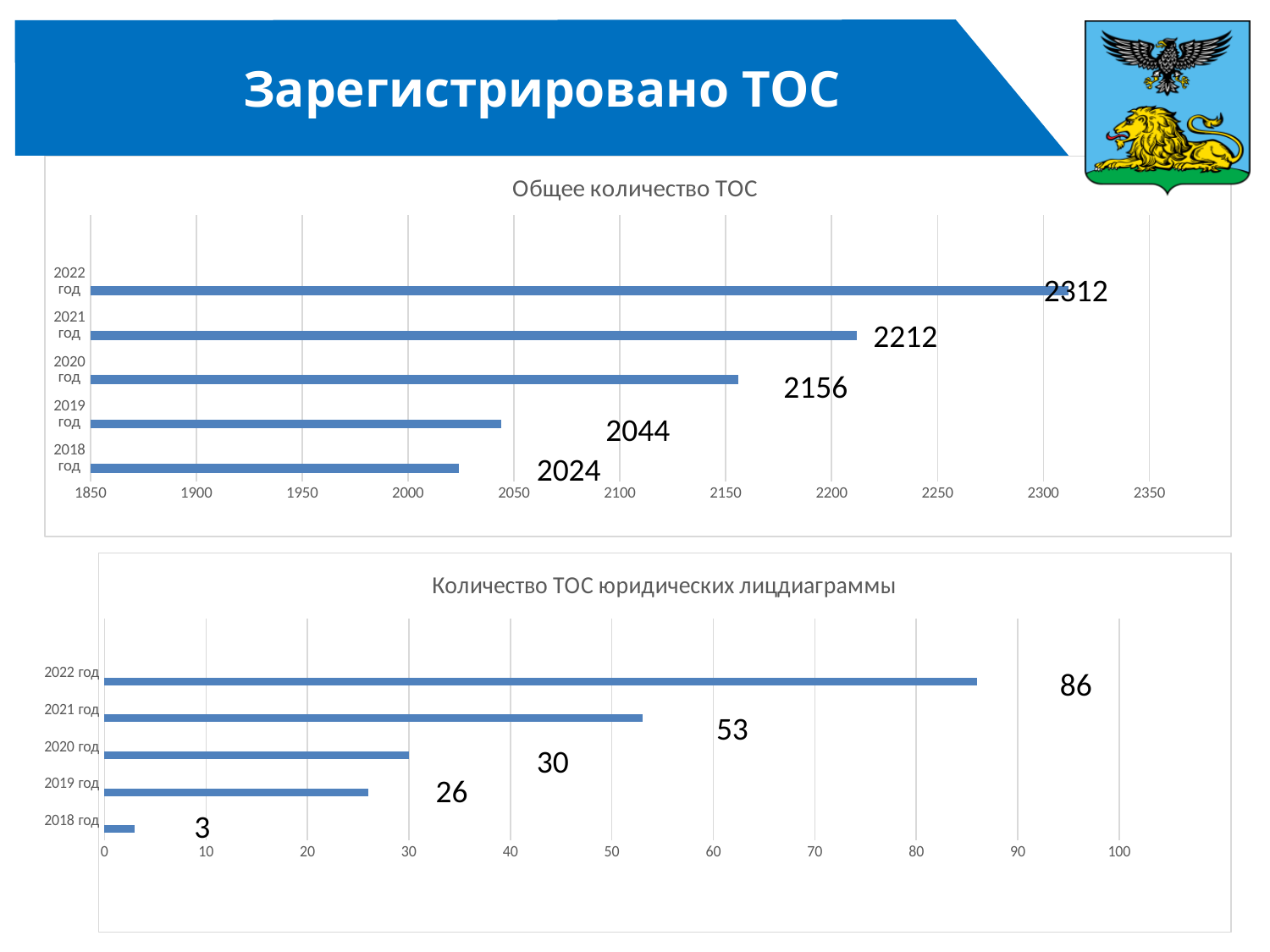
In the chart titled "Количество ТОС юридических лиц", which is larger, the value for 2021 год or 2020 год? 2021 год In the chart titled "Общее количество ТОС", do the values rise or fall from 2018 год to 2022 год? rise In the chart titled "Количество ТОС юридических лиц", what is the value for 2021 год? 53 In the chart titled "Общее количество ТОС", what is the value for 2022 год? 2312 In the chart titled "Количество ТОС юридических лиц", what is the value for 2018 год? 3 In the chart titled "Общее количество ТОС", how many years are plotted? 5 What kind of chart is the chart titled "Общее количество ТОС"? bar chart In the chart titled "Количество ТОС юридических лиц", what is the difference between the values for 2020 год and 2019 год? 4 In the chart titled "Общее количество ТОС", what is the difference between the values for 2022 год and 2021 год? 100 In the chart titled "Количество ТОС юридических лиц", which year has the highest value? 2022 год In the chart titled "Общее количество ТОС", what is the value for 2018 год? 2024 In the chart titled "Общее количество ТОС", which year has the lowest value? 2018 год